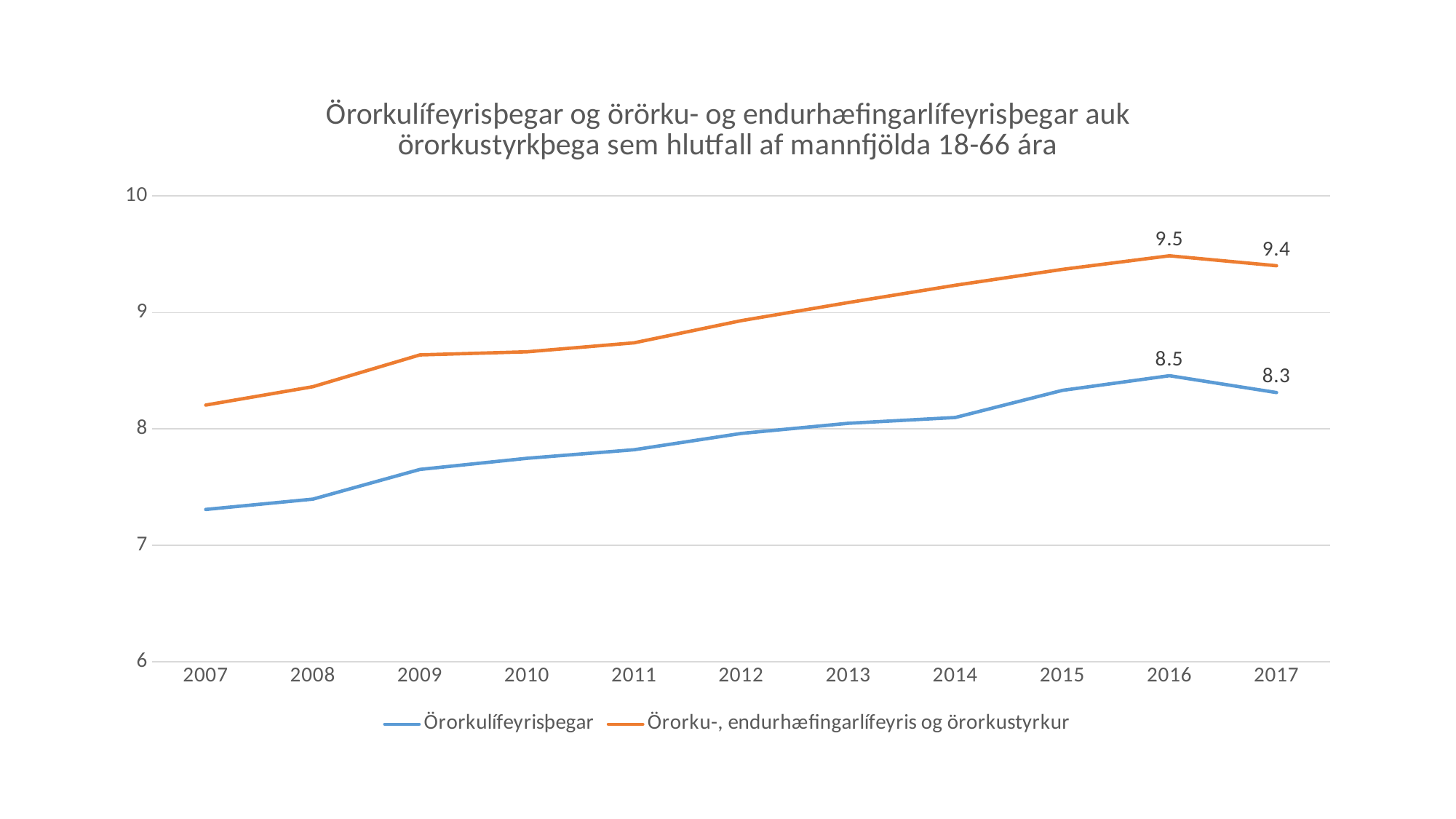
What is the value for Örorkulífeyrisþegar in 2017? 8.3 How many years are shown on the x axis? 11 Is the value for Örorkulífeyrisþegar in 2007 greater or less than 8? less What is the value for Örorkulífeyrisþegar in 2016? 8.5 What type of chart is shown on the slide? line chart What is the difference between the two series in 2016? 1.0 What is the value for Örorku-, endurhæfingarlífeyris og örorkustyrkur in 2017? 9.4 Which series has the higher value in 2017? Örorku-, endurhæfingarlífeyris og örorkustyrkur What is the value for Örorku-, endurhæfingarlífeyris og örorkustyrkur in 2016? 9.5 Is the value for Örorku-, endurhæfingarlífeyris og örorkustyrkur in 2012 greater or less than 9? less Does the Örorkulífeyrisþegar line generally rise or fall from 2007 to 2016? rise How many series does the legend list? 2